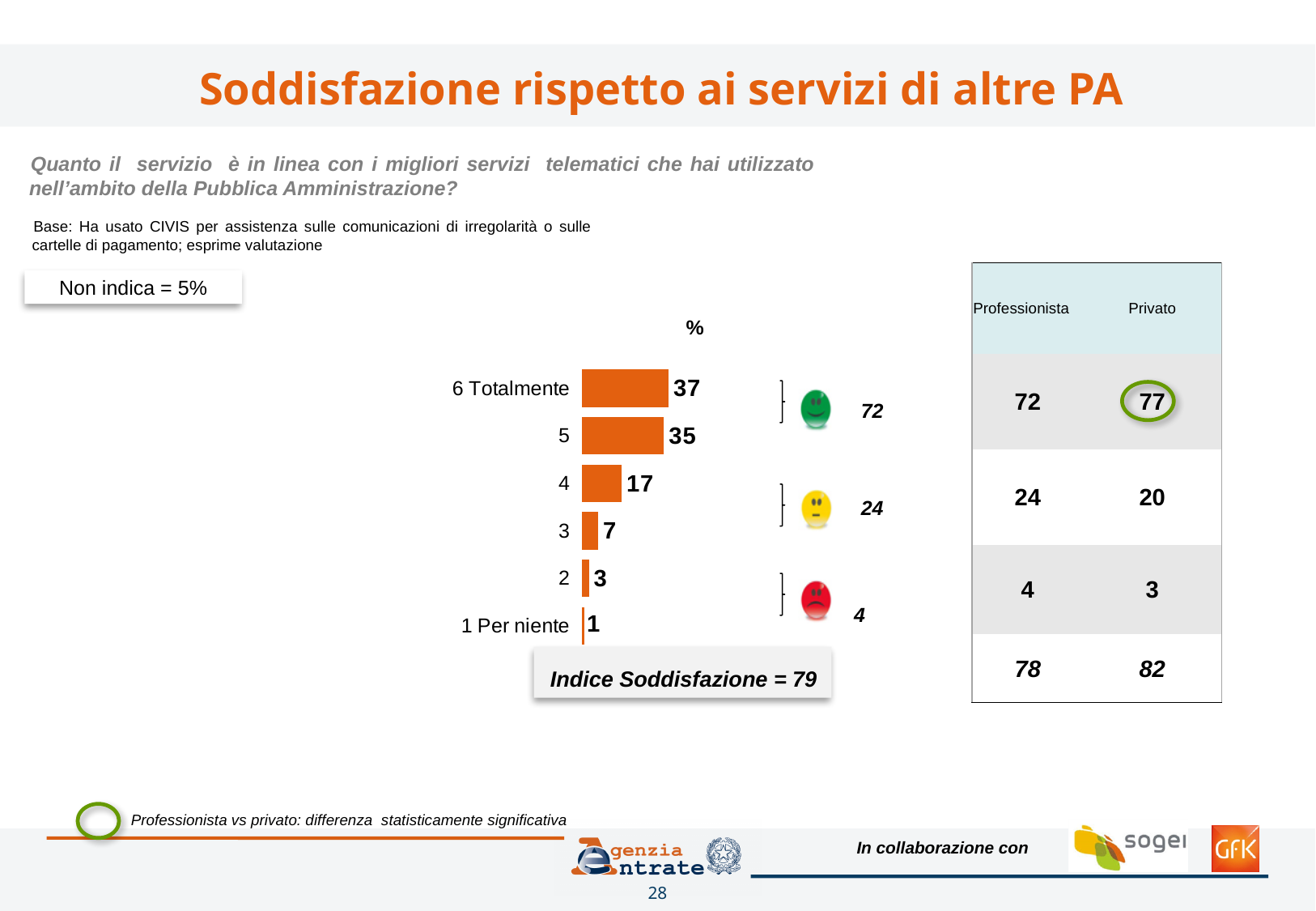
What kind of chart is shown on the slide? bar chart What is the value for the category "6 Totalmente"? 37 Which category has the lowest value? 1 Per niente How many categories are shown in the bar chart? 6 What is the value for the category "1 Per niente"? 1 What is the value of the "Indice Soddisfazione" shown below the chart? 79 Which category has the highest value? 6 Totalmente What is the total of the values for "6 Totalmente" and "5" combined? 72 What percentage is given for "Non indica" on the slide? 5% What is the difference between the values for "4" and "3"? 10 What is the value for the category "5"? 35 Which is larger, the value for "5" or the value for "4"? 5